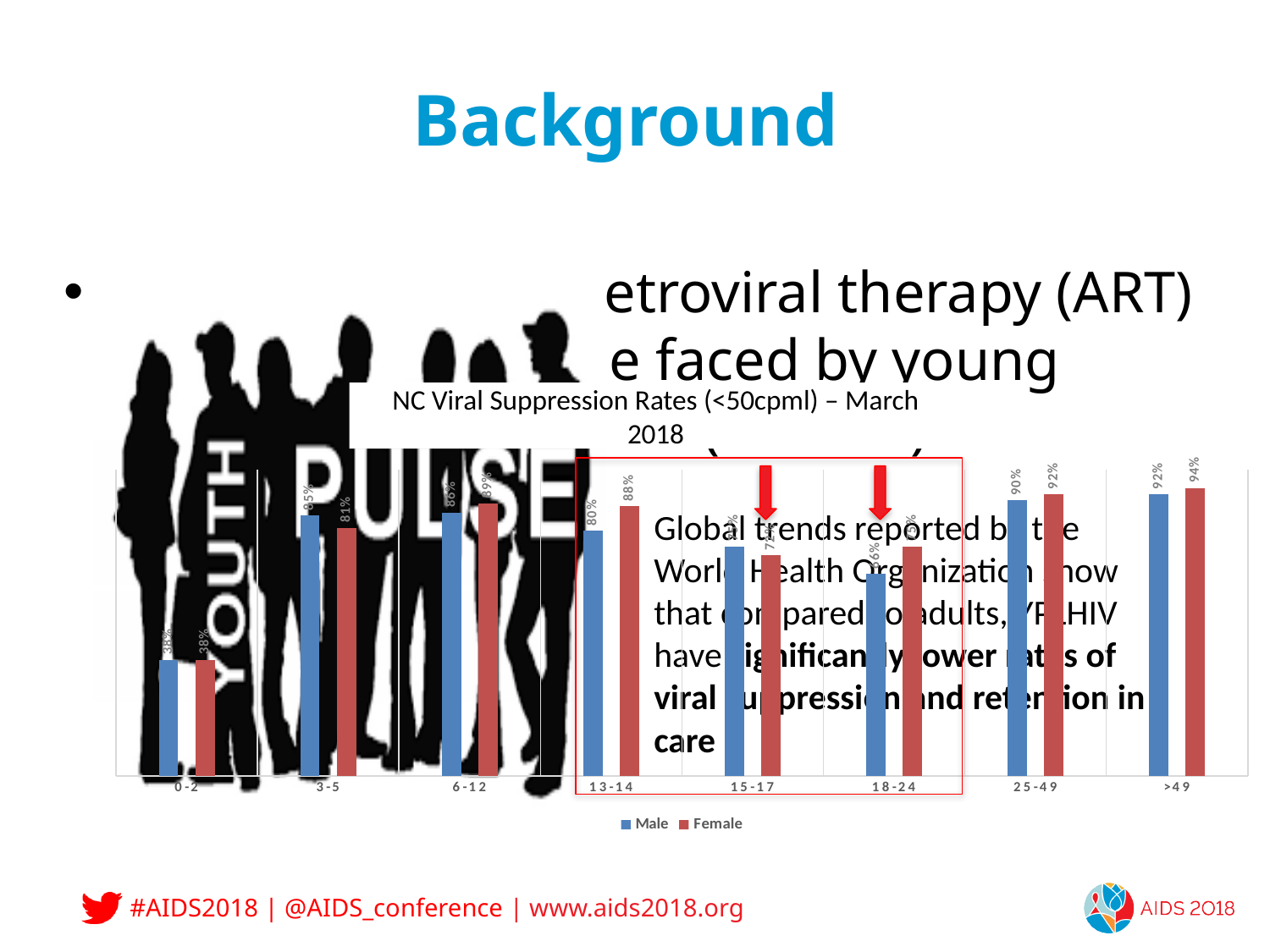
Which age group has the lowest Male viral suppression rate? 0-2 How many series does the chart legend list? 2 What is the Male viral suppression rate for the 0-2 age group? 38% In the 13-14 age group, how many percentage points higher is the Female rate than the Male rate? 8 percentage points What is the Female viral suppression rate for the >49 age group? 94% Which age group has the highest Female viral suppression rate? >49 What kind of chart is shown on the slide? bar chart What is the Female viral suppression rate for the 13-14 age group? 88% What is the Male viral suppression rate for the 25-49 age group? 90% How many age-group categories are shown on the x axis of the chart? 8 What are the two series named in the chart legend? Male and Female In the 3-5 age group, which series has the higher viral suppression rate, Male or Female? Male